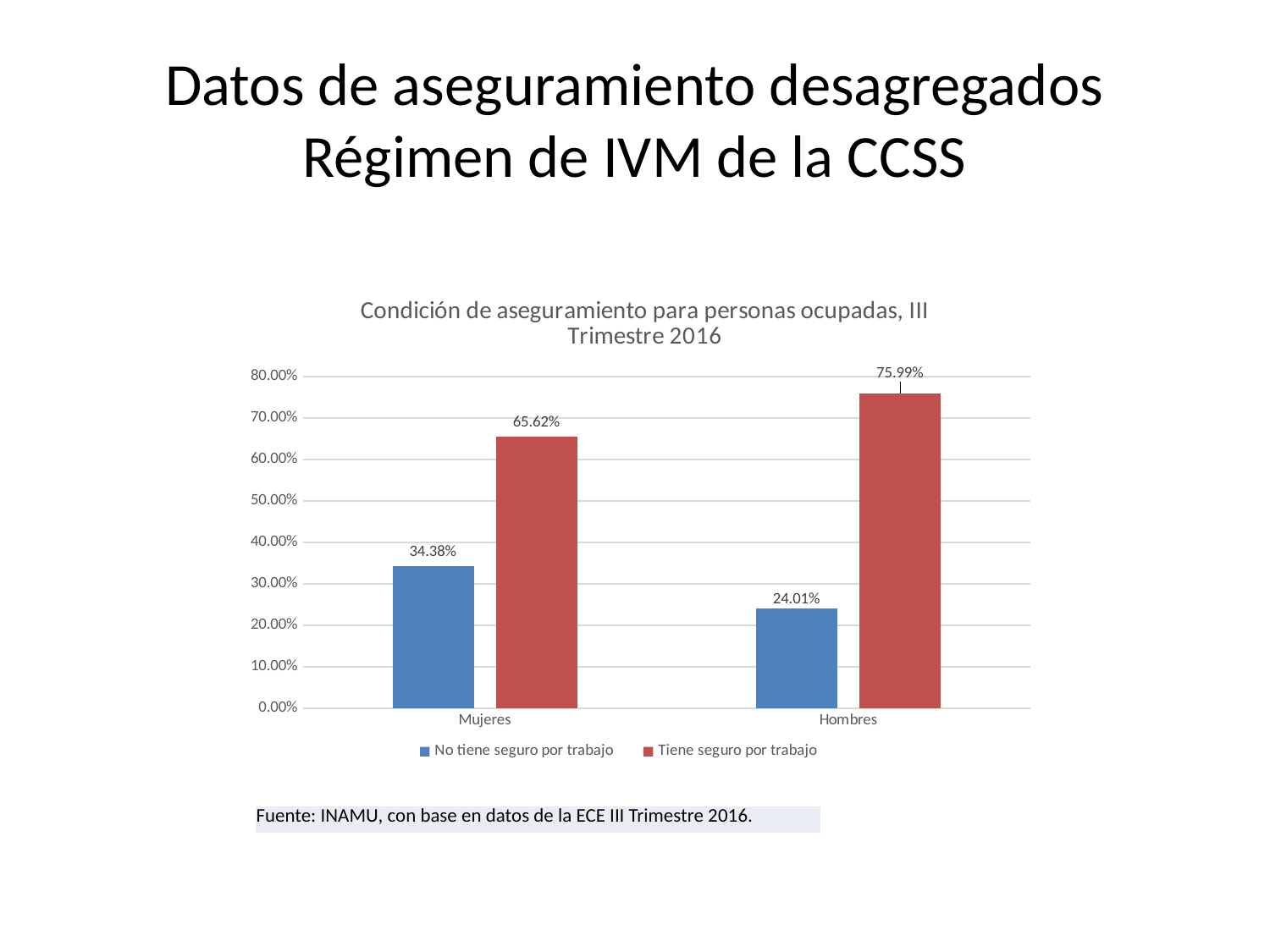
What is the value for Hombres in the 'No tiene seguro por trabajo' series? 24.01% Which is larger: the 'No tiene seguro por trabajo' value for Mujeres or for Hombres? Mujeres Which category has the highest value in the 'Tiene seguro por trabajo' series? Hombres What is the difference between the 'Tiene seguro por trabajo' values for Hombres and Mujeres? 10.37% Which category has the lowest value in the 'No tiene seguro por trabajo' series? Hombres What is the title of the chart? Condición de aseguramiento para personas ocupadas, III Trimestre 2016 What is the value for Mujeres in the 'Tiene seguro por trabajo' series? 65.62% What is the value for Hombres in the 'Tiene seguro por trabajo' series? 75.99% What is the value for Mujeres in the 'No tiene seguro por trabajo' series? 34.38% How many series does the legend list? 2 How many categories are shown on the x axis? 2 What kind of chart is shown on the slide? Bar chart